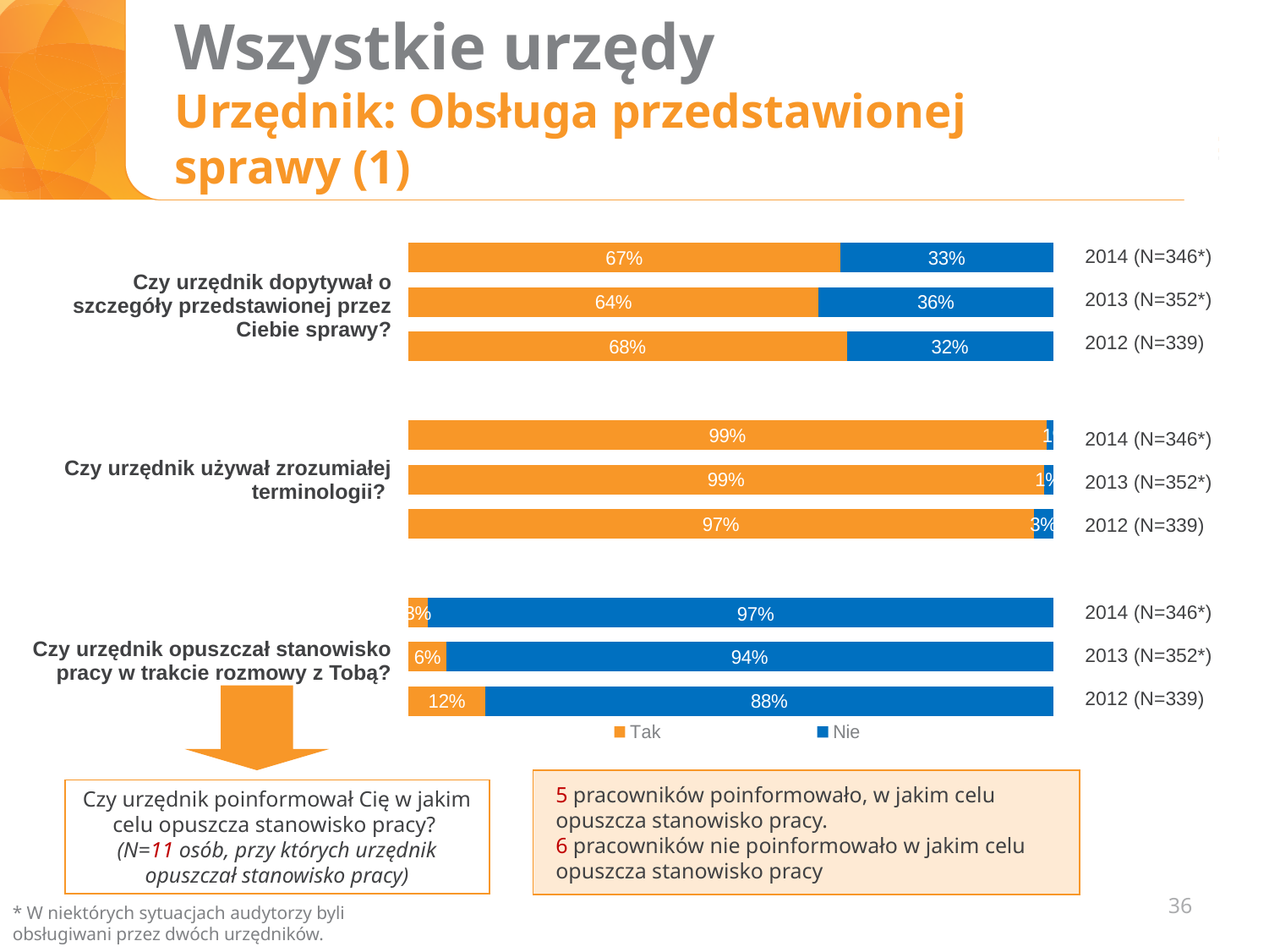
What percentage answered "Tak" in 2014 for "Czy urzędnik dopytywał o szczegóły przedstawionej przez Ciebie sprawy?"? 67% For "Czy urzędnik dopytywał o szczegóły przedstawionej przez Ciebie sprawy?", which year had the highest "Tak" share? 2012 How many series does the chart legend list? 2 What is the difference in percentage points between the "Tak" share in 2012 and in 2013 for "Czy urzędnik opuszczał stanowisko pracy w trakcie rozmowy z Tobą?"? 6 percentage points For "Czy urzędnik opuszczał stanowisko pracy w trakcie rozmowy z Tobą?", which year had the lowest "Tak" share? 2014 What percentage answered "Nie" in 2013 for "Czy urzędnik dopytywał o szczegóły przedstawionej przez Ciebie sprawy?"? 36% Which colour represents the "Nie" answers in the chart? Blue What percentage answered "Nie" in 2014 for "Czy urzędnik opuszczał stanowisko pracy w trakcie rozmowy z Tobą?"? 97% What percentage answered "Tak" in 2012 for "Czy urzędnik używał zrozumiałej terminologii?"? 97% For "Czy urzędnik dopytywał o szczegóły przedstawionej przez Ciebie sprawy?", was the "Tak" share larger in 2014 or in 2013? 2014 What percentage answered "Tak" in 2012 for "Czy urzędnik opuszczał stanowisko pracy w trakcie rozmowy z Tobą?"? 12% What type of chart is shown on the slide? Stacked bar chart